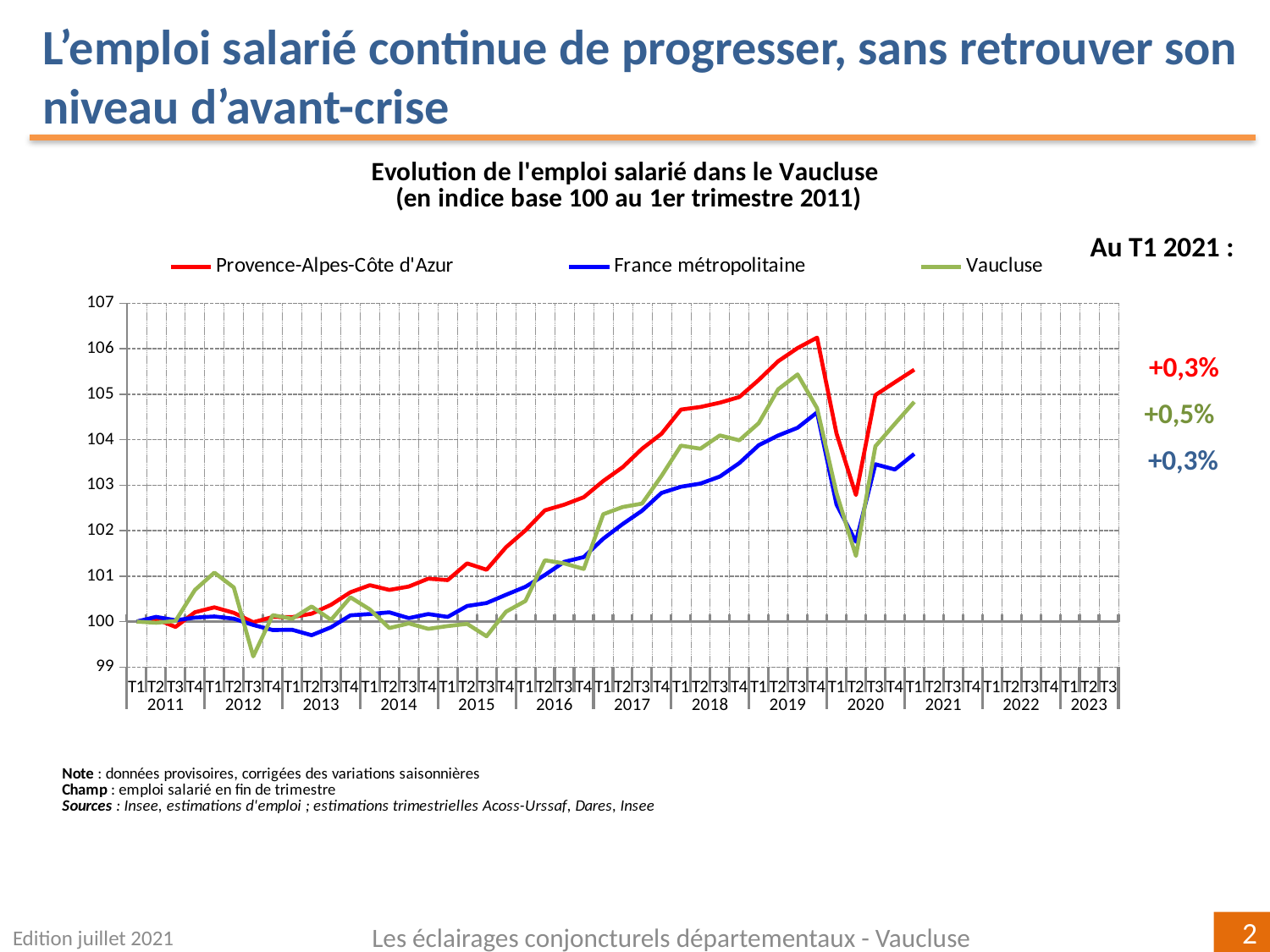
How many series does the legend list? 3 Which series has the lowest index value at T2 2020? Vaucluse Does the Provence-Alpes-Côte d'Azur index rise or fall between 2015 and 2019? rise What is the title of the chart? Evolution de l'emploi salarié dans le Vaucluse (en indice base 100 au 1er trimestre 2011) According to the annotation 'Au T1 2021', what is the change shown for Vaucluse? +0,5% What kind of chart is shown on the slide? line chart At T1 2021, is the index for Provence-Alpes-Côte d'Azur greater or less than 105? greater Which series is drawn in green? Vaucluse Which series has the highest index value at T1 2021? Provence-Alpes-Côte d'Azur At T2 2020, is the index for Vaucluse greater or less than 102? less At T1 2021, which is higher: the index for Provence-Alpes-Côte d'Azur or for France métropolitaine? Provence-Alpes-Côte d'Azur According to the annotation 'Au T1 2021', what is the change shown for Provence-Alpes-Côte d'Azur? +0,3%